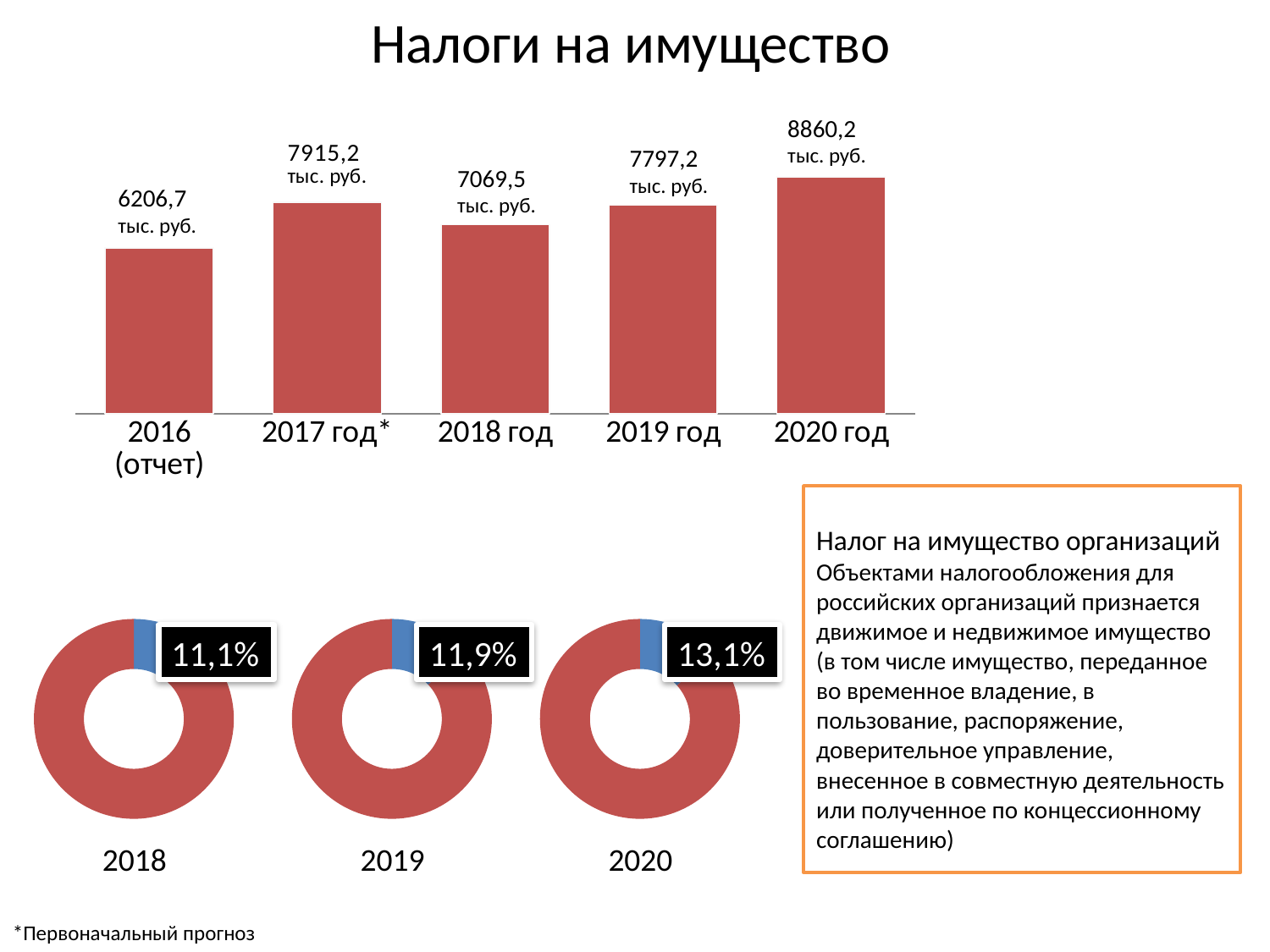
In the donut chart labelled 2019 at the bottom of the slide, what percentage is shown for the blue slice? 11,9% In the bar chart at the top of the slide, which year has the highest value? 2020 год How many bars are in the bar chart at the top of the slide? 5 In the donut chart labelled 2020 at the bottom of the slide, what percentage is shown for the blue slice? 13,1% In the bar chart at the top of the slide, which is larger: the value for 2017 год* or the value for 2019 год? 2017 год* In the bar chart at the top of the slide, what is the value for 2016 (отчет)? 6206,7 тыс. руб. In the bar chart at the top of the slide, what is the difference between the values for 2017 год* and 2018 год? 845,7 тыс. руб. In the bar chart at the top of the slide, what is the value for 2020 год? 8860,2 тыс. руб. In the bar chart at the top of the slide, what is the difference between the values for 2020 год and 2016 (отчет)? 2653,5 тыс. руб. In the bar chart at the top of the slide, which year has the lowest value? 2016 (отчет) In the bar chart at the top of the slide, what is the value for 2018 год? 7069,5 тыс. руб. What kind of chart is shown at the top of the slide? Bar chart